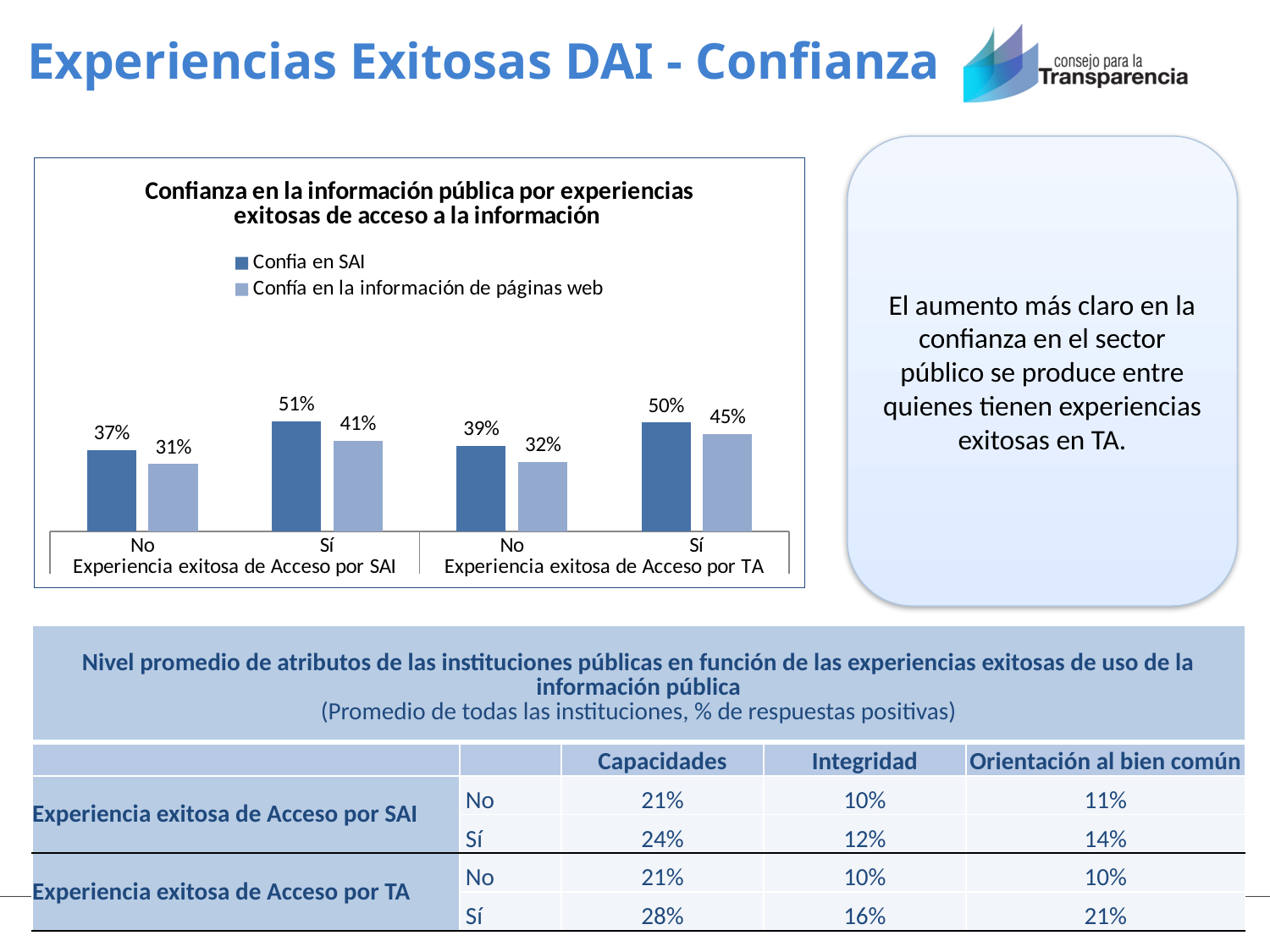
Which category has the lowest value for 'Confia en SAI'? No (Experiencia exitosa de Acceso por SAI) Which is larger: 'Confia en SAI' for 'Sí' under 'Experiencia exitosa de Acceso por TA' or 'Confía en la información de páginas web' for the same category? Confia en SAI Which category has the highest value for 'Confía en la información de páginas web'? Sí (Experiencia exitosa de Acceso por TA) What type of chart is shown on the slide? bar chart What is the value of 'Confía en la información de páginas web' for 'Sí' under 'Experiencia exitosa de Acceso por TA'? 45% What is the title of the chart? Confianza en la información pública por experiencias exitosas de acceso a la información How many category groups are shown along the x axis of the chart? 4 What is the difference between 'Confia en SAI' for 'Sí' and 'No' under 'Experiencia exitosa de Acceso por SAI'? 14% How many series does the chart legend list? 2 What is the value of 'Confia en SAI' for 'Sí' under 'Experiencia exitosa de Acceso por SAI'? 51% What is the value of 'Confia en SAI' for 'No' under 'Experiencia exitosa de Acceso por SAI'? 37% What is the value of 'Confía en la información de páginas web' for 'No' under 'Experiencia exitosa de Acceso por TA'? 32%